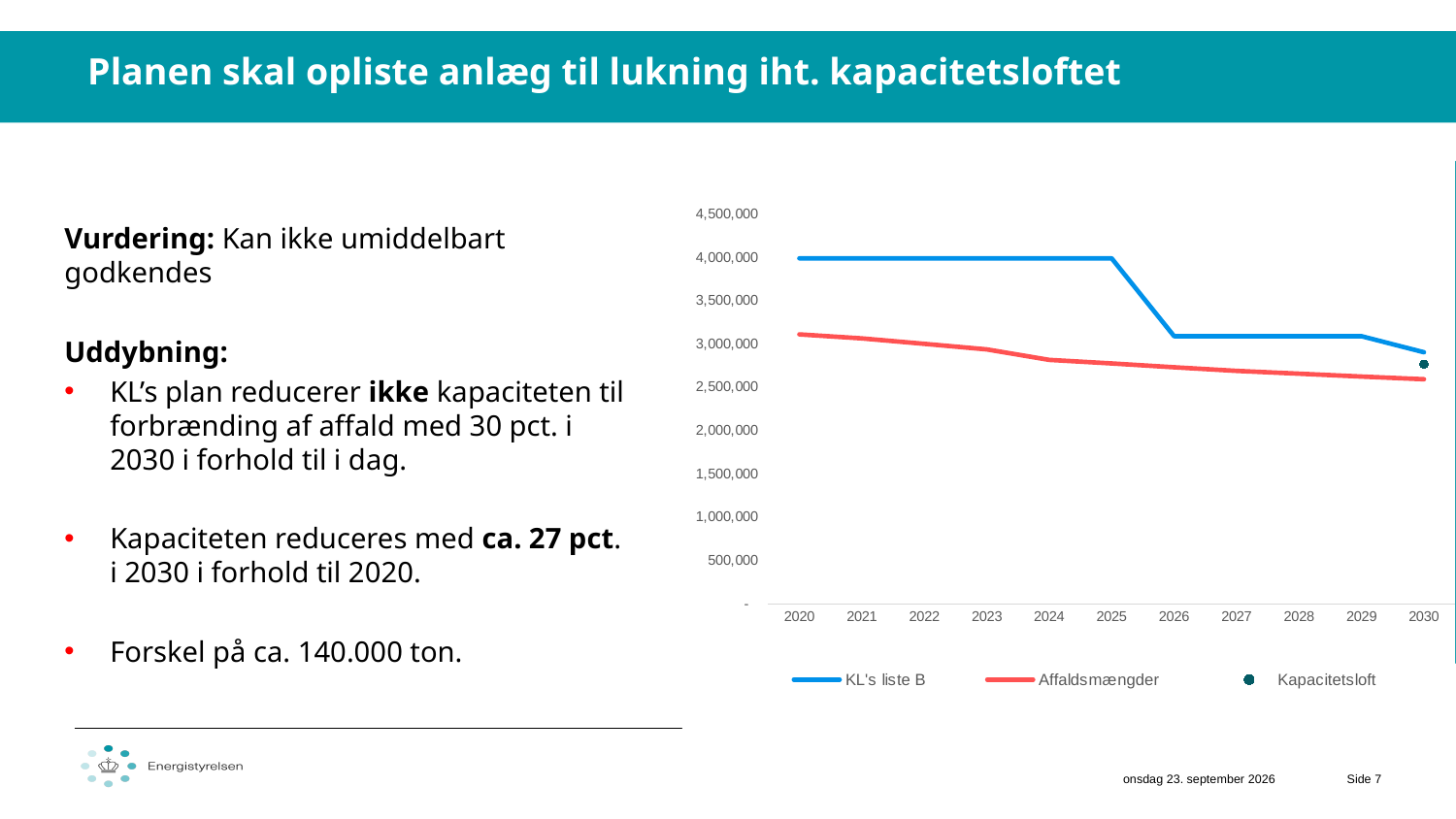
Is the value for Affaldsmængder in 2024 greater or less than 3,000,000? less Does the Affaldsmængder line rise or fall from 2020 to 2030? fall Is the value for Affaldsmængder in 2030 greater or less than 3,000,000? less Is the value for KL's liste B in 2020 greater or less than 3,500,000? greater How many years are shown on the x axis of the chart? 11 In 2020, which is higher: KL's liste B or Affaldsmængder? KL's liste B What kind of chart is shown on the slide? line chart Does the KL's liste B line rise or fall from 2020 to 2030? fall Which legend entry is shown as a single point rather than a line? Kapacitetsloft How many series does the chart legend list? 3 In which year is the Affaldsmængder line at its lowest? 2030